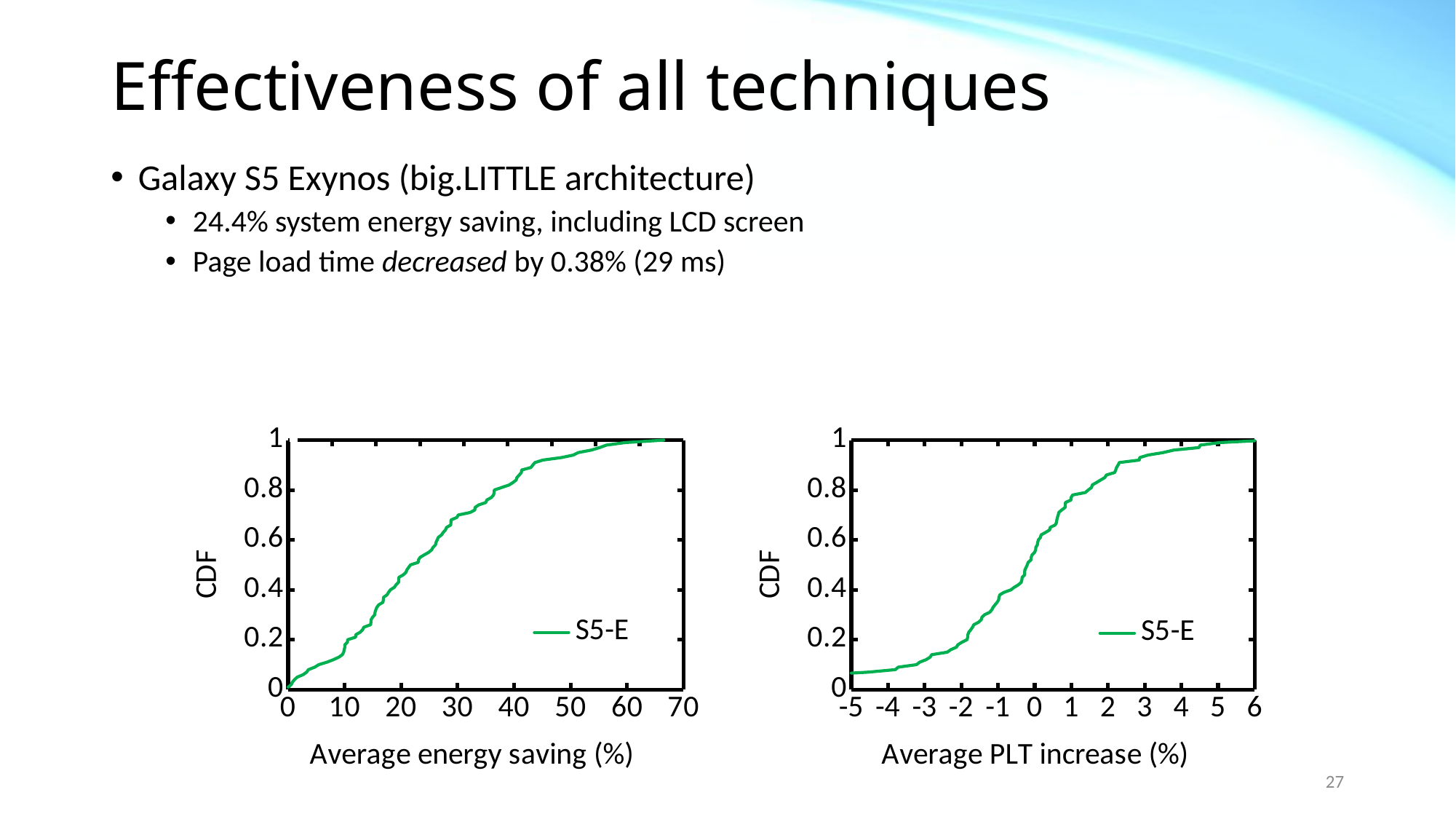
What kind of chart is the left chart (Average energy saving)? line chart In the right chart (Average PLT increase), is the CDF value at a PLT increase of -3% greater or less than 0.2? less In the left chart (Average energy saving), is the CDF value at 30% energy saving greater or less than 0.6? greater In the left chart, does the CDF rise or fall as average energy saving increases along the x axis? rise In the right chart, does the CDF rise or fall as average PLT increase goes from -5 to 6? rise In the left chart (Average energy saving), is the CDF value at 10% energy saving greater or less than 0.2? less In the left chart (Average energy saving), how many series does the legend list? 1 What is the x-axis label of the left chart? Average energy saving (%) In the right chart (Average PLT increase), what series name does the legend show? S5-E What kind of chart is the right chart (Average PLT increase)? line chart